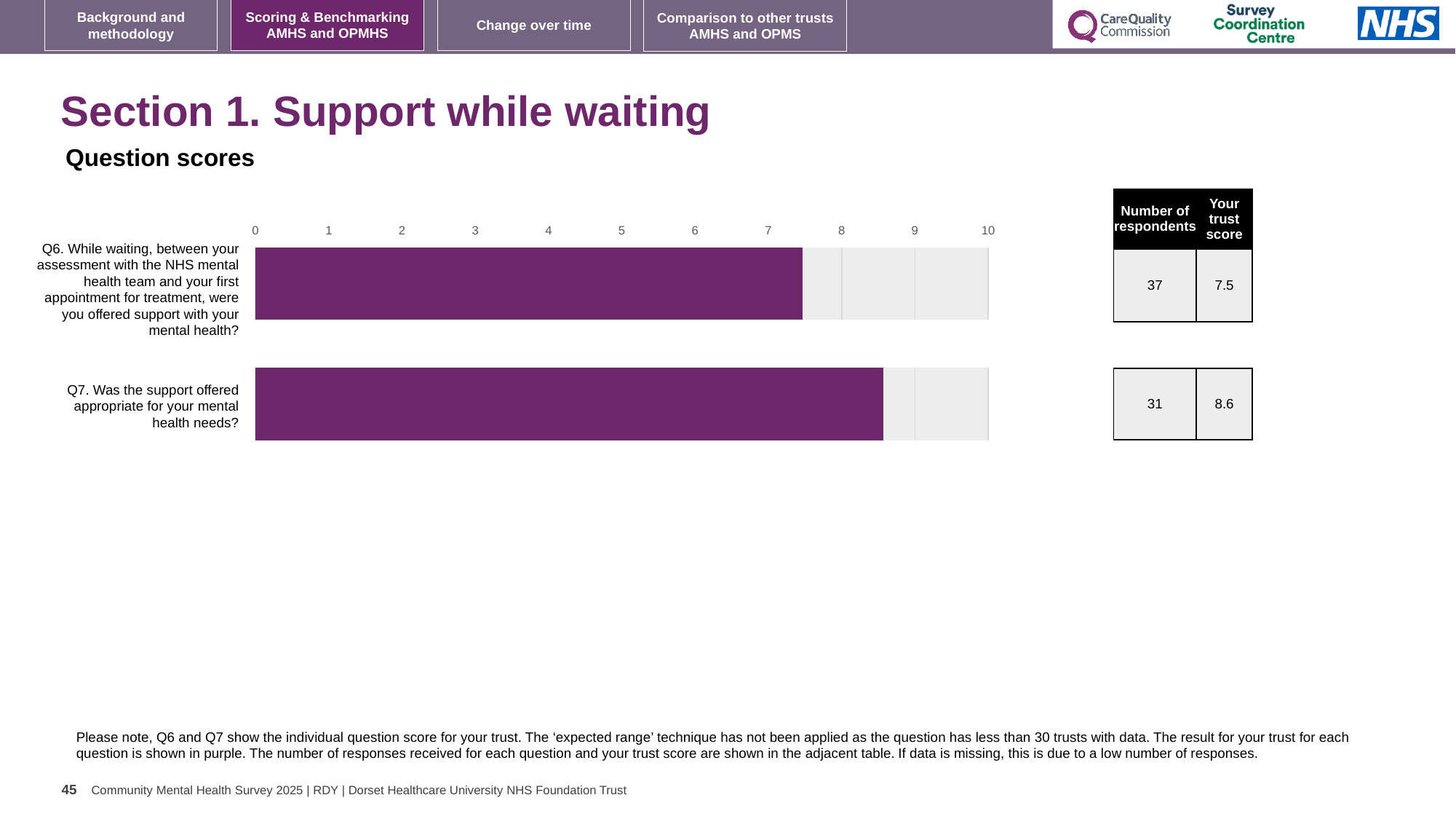
Is the trust score for Q7 greater or less than 8? greater What is the trust score for Q6 (support offered while waiting)? 7.5 How many respondents answered Q6? 37 Is the trust score for Q6 greater or less than 8? less What is the trust score for Q7 (was the support offered appropriate)? 8.6 Which question has the lowest trust score? Q6 What is the maximum value shown on the chart's horizontal axis? 10 What is the difference between the trust scores for Q7 and Q6? 1.1 What kind of chart is shown on the slide? bar chart Which question has the higher trust score, Q6 or Q7? Q7 How many respondents answered Q7? 31 How many questions (bars) are plotted in the chart? 2